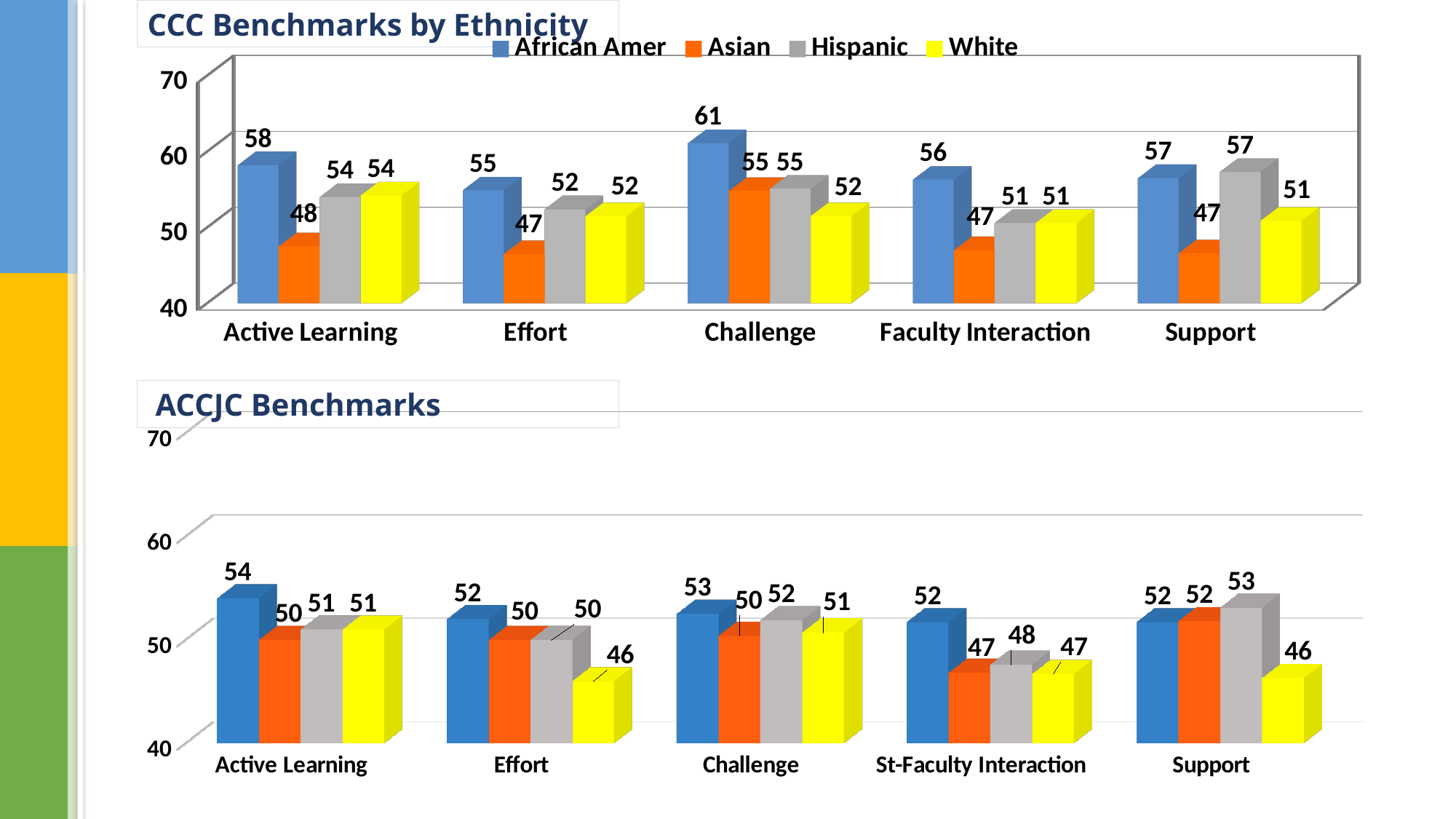
What kind of chart is the ACCJC Benchmarks chart? bar chart In the CCC Benchmarks by Ethnicity chart, which category has the highest African Amer value? Challenge In the ACCJC Benchmarks chart, what is the value of the yellow bar for Effort? 46 In the CCC Benchmarks by Ethnicity chart, what is the difference between the African Amer and Asian values for Effort? 8 How many categories are shown on the x axis of the ACCJC Benchmarks chart? 5 How many series does the legend of the CCC Benchmarks by Ethnicity chart list? 4 In the CCC Benchmarks by Ethnicity chart, what is the value for Asian in Active Learning? 48 In the CCC Benchmarks by Ethnicity chart, what is the value for Hispanic in Support? 57 In the CCC Benchmarks by Ethnicity chart, which is larger for Faculty Interaction: the African Amer value or the White value? African Amer In the CCC Benchmarks by Ethnicity chart, what is the value for African Amer in Challenge? 61 In the ACCJC Benchmarks chart, what is the value of the blue bar for Active Learning? 54 In the ACCJC Benchmarks chart, what is the difference between the grey bar and the yellow bar for Support? 7